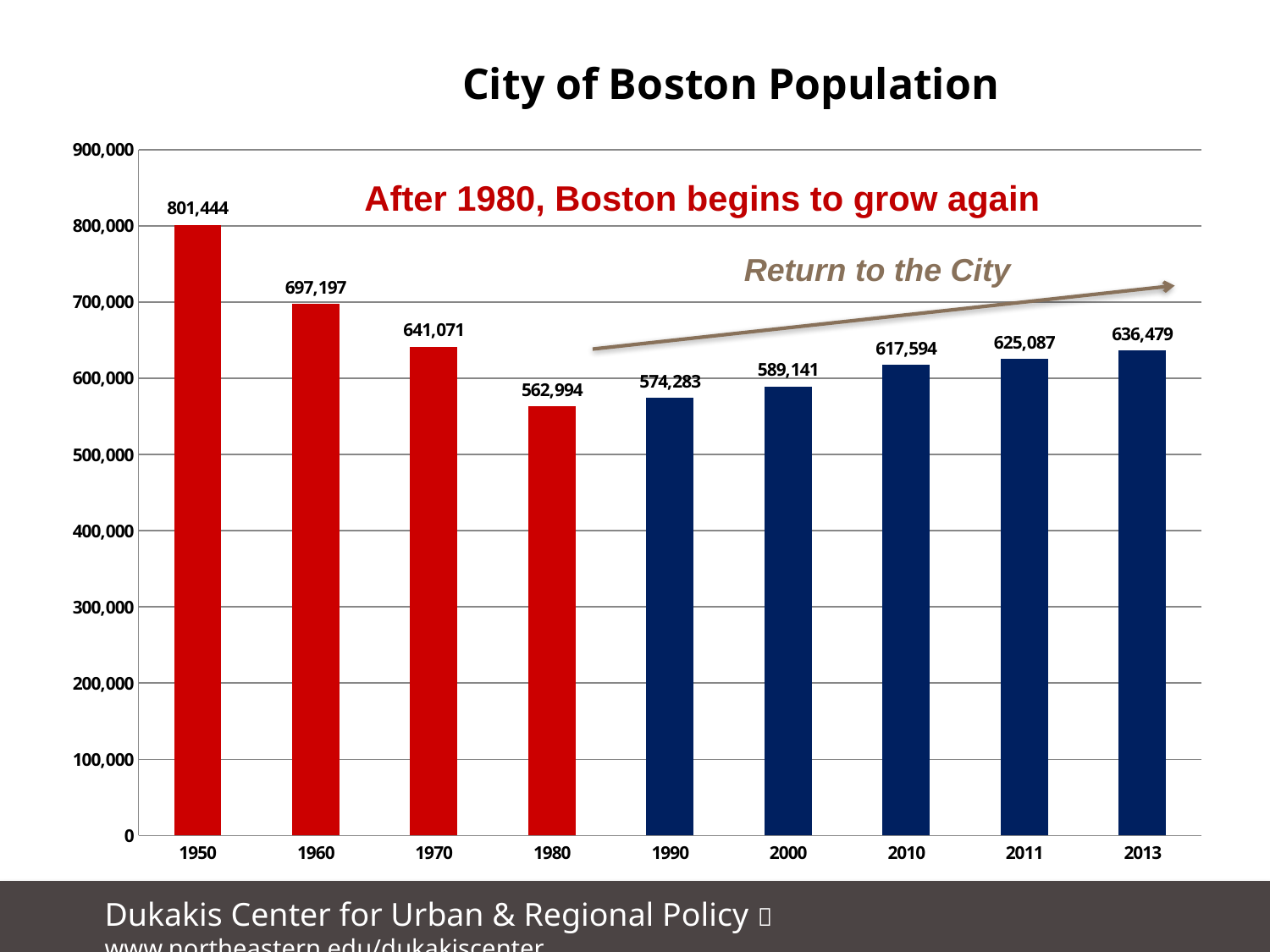
Which year has the highest population value on the chart? 1950 Which is larger, the population in 1970 or in 2013? 1970 Which year has the lowest population value on the chart? 1980 How many years are shown on the x axis of the chart? 9 Is the population value for 2000 greater or less than 600,000? less What is the difference between the 2013 and 1990 population values? 62,196 Do the population values rise or fall from 1990 to 2013? rise What kind of chart is shown on the slide? bar chart What was the City of Boston population in 2013? 636,479 What was the City of Boston population in 1950? 801,444 What is the difference between the 1950 and 1980 population values? 238,450 What was the City of Boston population in 1980? 562,994